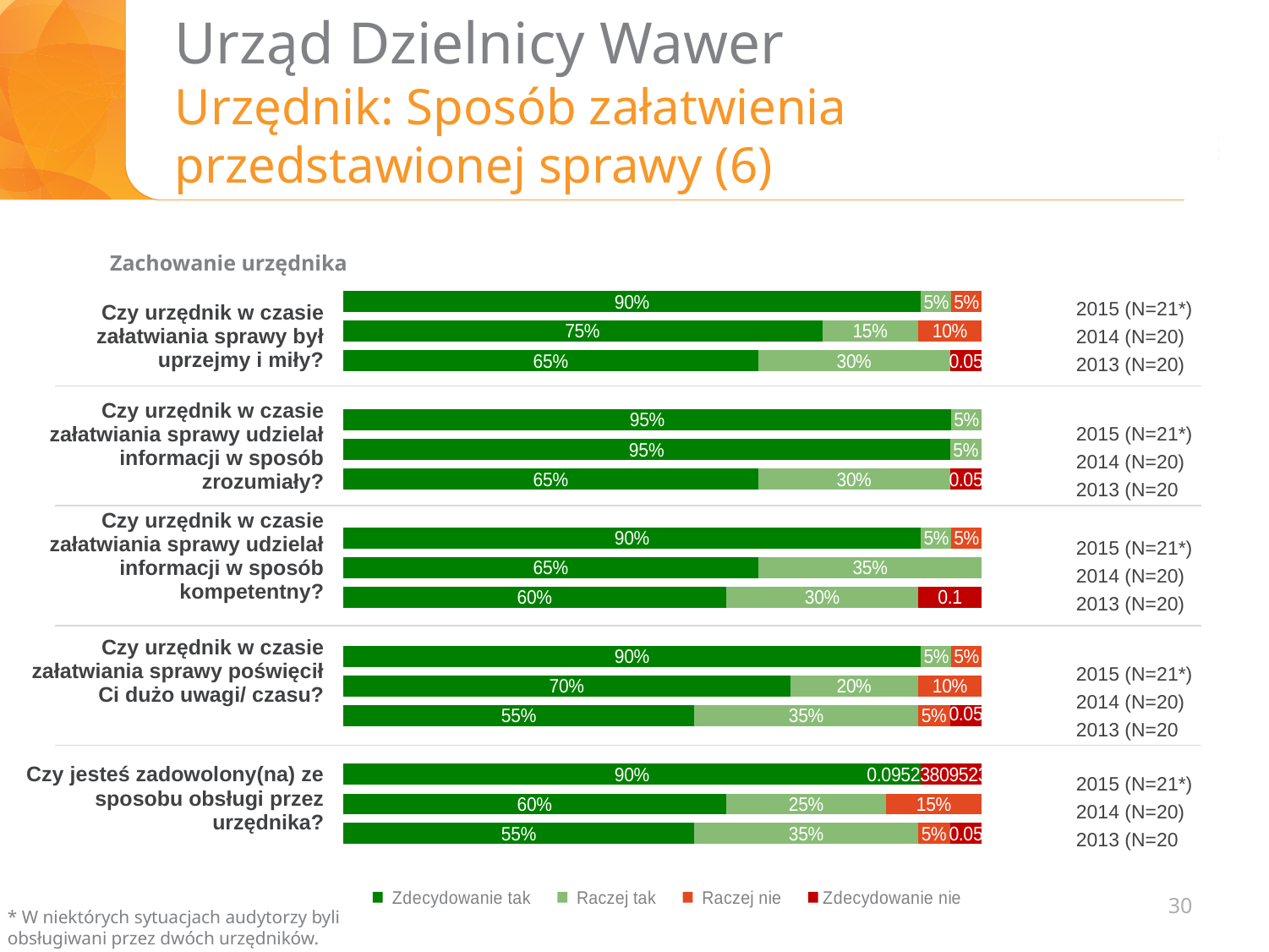
In the chart for "Czy urzędnik w czasie załatwiania sprawy udzielał informacji w sposób kompetentny?", what is the "Raczej tak" value for 2014? 35% In the chart for "Czy urzędnik w czasie załatwiania sprawy poświęcił Ci dużo uwagi/ czasu?", which is larger: the "Zdecydowanie tak" value for 2014 or for 2013? 2014 In the chart for "Czy jesteś zadowolony(na) ze sposobu obsługi przez urzędnika?", which year has the highest "Zdecydowanie tak" value? 2015 In the chart for "Czy urzędnik w czasie załatwiania sprawy udzielał informacji w sposób zrozumiały?", what is the "Zdecydowanie tak" value for 2015? 95% In the chart for "Czy urzędnik w czasie załatwiania sprawy poświęcił Ci dużo uwagi/ czasu?", what is the "Zdecydowanie tak" value for 2013? 55% What kind of chart is used on this slide? Stacked bar chart In the chart for "Czy urzędnik w czasie załatwiania sprawy był uprzejmy i miły?", what is the "Zdecydowanie tak" value for 2015? 90% How many series does the legend list? 4 In the chart for "Czy urzędnik w czasie załatwiania sprawy był uprzejmy i miły?", what is the "Raczej tak" value for 2014? 15% In the chart for "Czy jesteś zadowolony(na) ze sposobu obsługi przez urzędnika?", what is the "Raczej nie" value for 2014? 15% In the chart for "Czy urzędnik w czasie załatwiania sprawy był uprzejmy i miły?", what is the difference between the "Zdecydowanie tak" values for 2015 and 2013? 25% Which legend entry is shown in dark red? Zdecydowanie nie